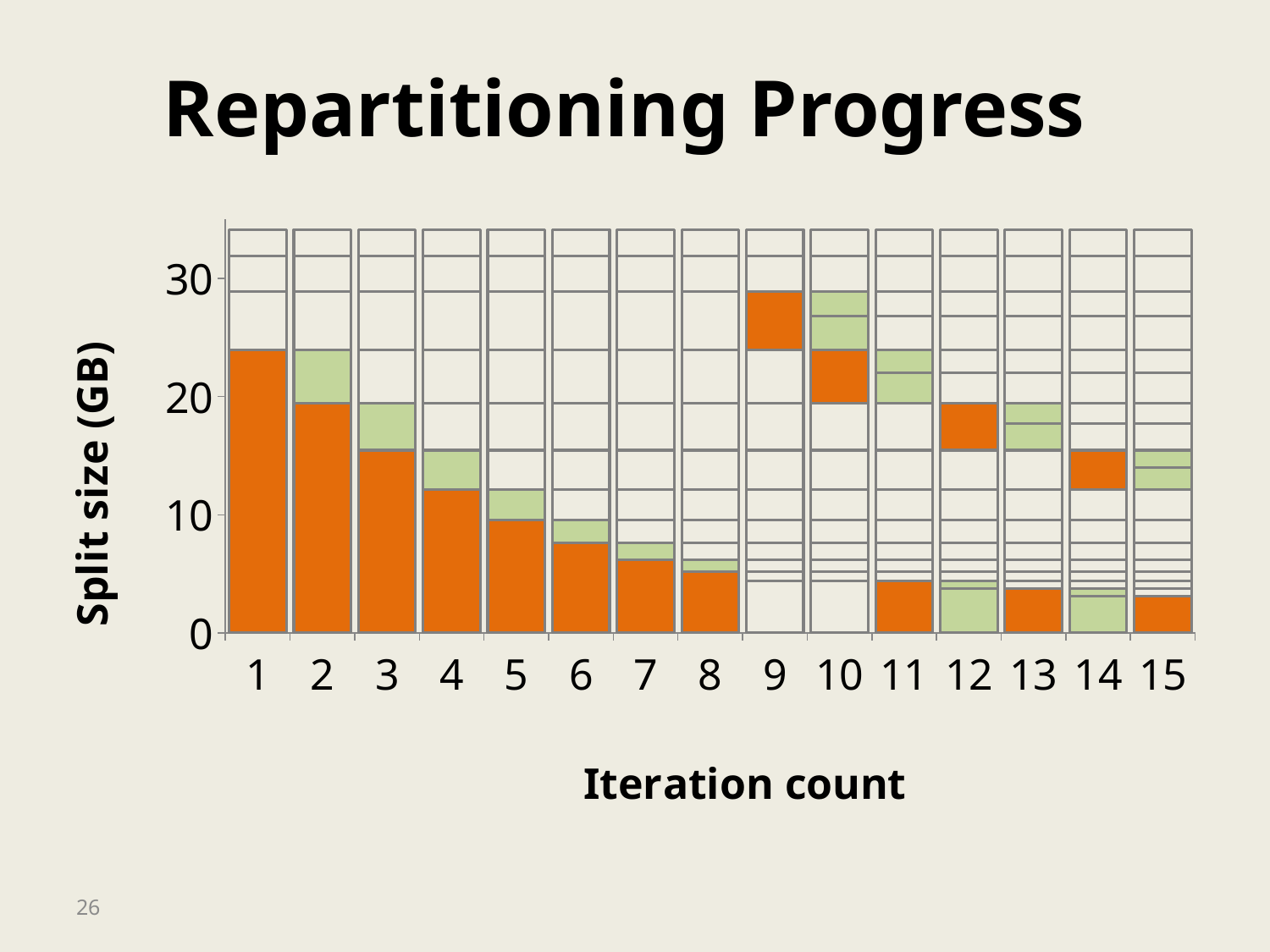
Which has the taller orange bar, iteration 1 or iteration 8? Iteration 1 Which has the taller orange bar, iteration 2 or iteration 6? Iteration 2 Is the orange bar for iteration 15 greater or less than 10? less What kind of chart is shown on the slide? Bar chart Is the orange bar for iteration 3 greater or less than 20? less Is the orange bar for iteration 8 greater or less than 10? less How many iterations are shown along the x axis of the chart? 15 Do the orange bars rise or fall from iteration 1 to iteration 8? Fall What is the label of the y axis? Split size (GB) What is the title of the chart? Repartitioning Progress